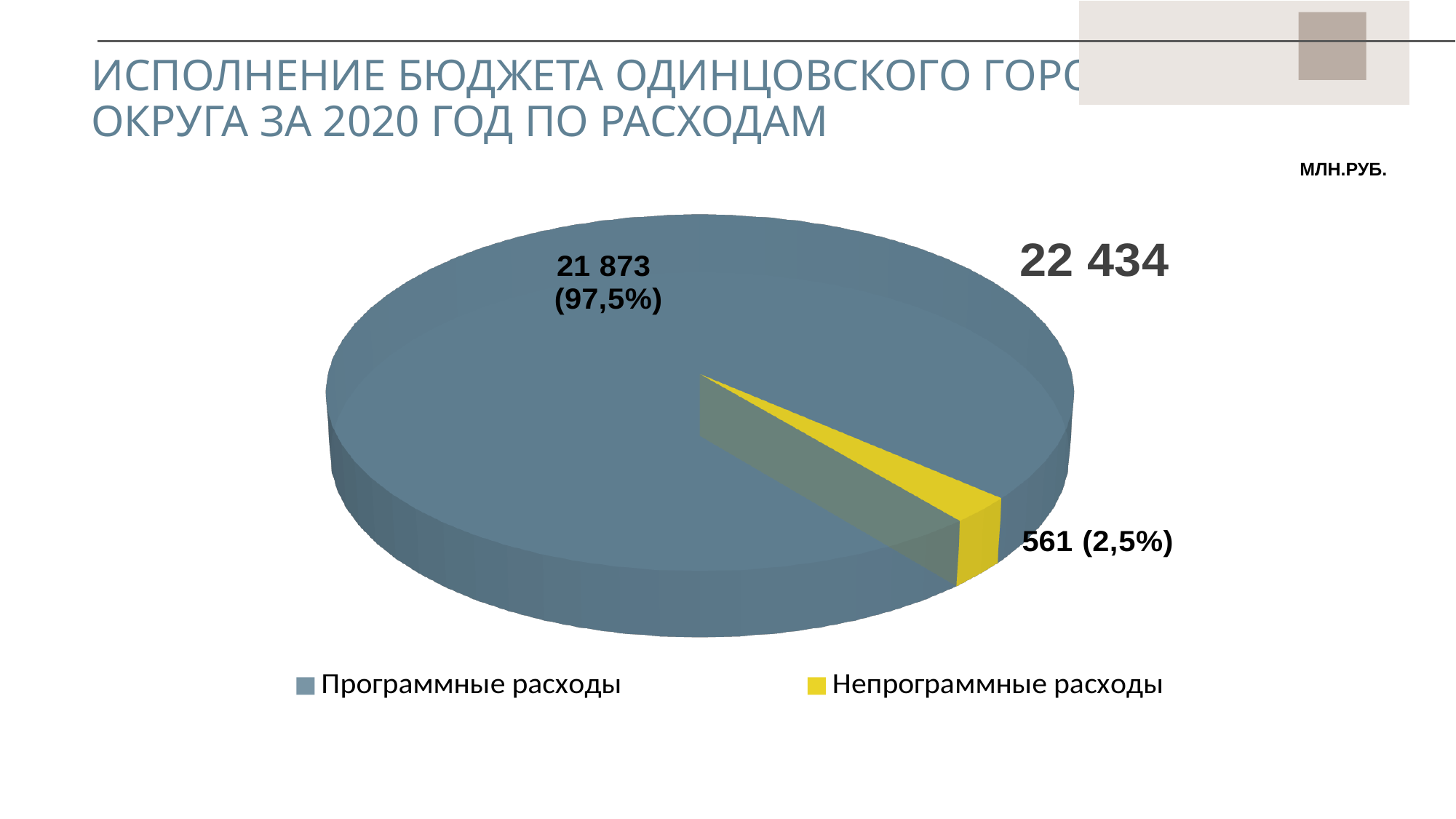
Which category has the smallest slice? Непрограммные расходы What share of the pie does Непрограммные расходы take? 2,5% What is the value for Программные расходы? 21 873 Which is larger, Программные расходы or Непрограммные расходы? Программные расходы What is the difference between the values for Программные расходы and Непрограммные расходы? 21 312 How many slices does the pie chart have? 2 What total value is shown next to the pie chart? 22 434 Which category has the largest slice? Программные расходы What kind of chart is shown on the slide? Pie chart What share of the pie does Программные расходы take? 97,5% What is the value for Непрограммные расходы? 561 What colour is the slice for Непрограммные расходы? Yellow